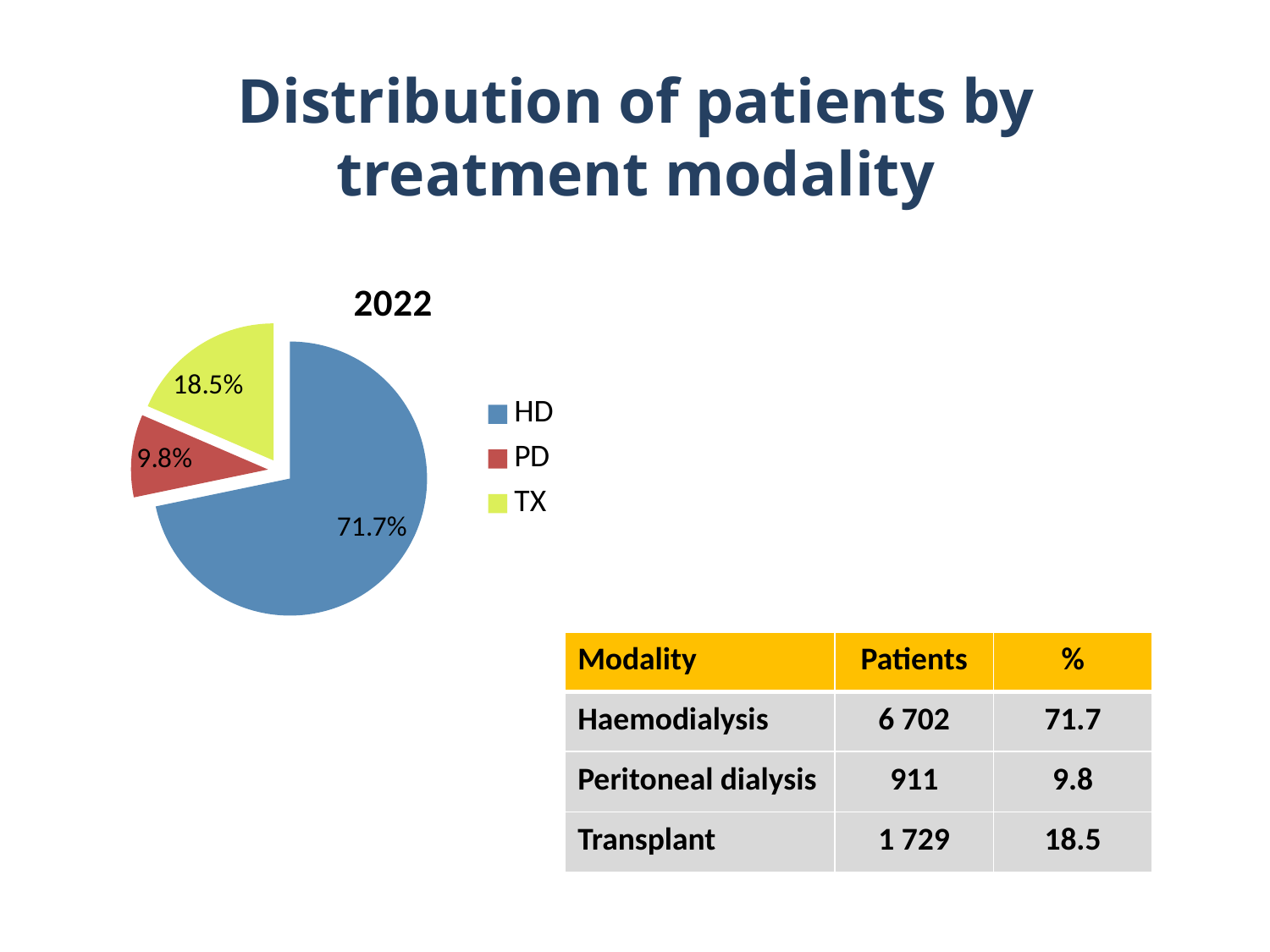
Which treatment modality has the smallest slice of the pie? PD Which treatment modality has the largest slice of the pie? HD How many entries does the legend list? 3 What is the difference in percentage points between the HD and TX slices? 53.2 What share of the pie does TX represent? 18.5% What share of the pie does PD represent? 9.8% What is the title of the pie chart? 2022 Which colour represents TX in the pie chart? yellow-green What type of chart is shown on the slide? pie chart Which slice is larger, TX or PD? TX How many slices does the pie chart have? 3 What share of the pie does HD represent? 71.7%